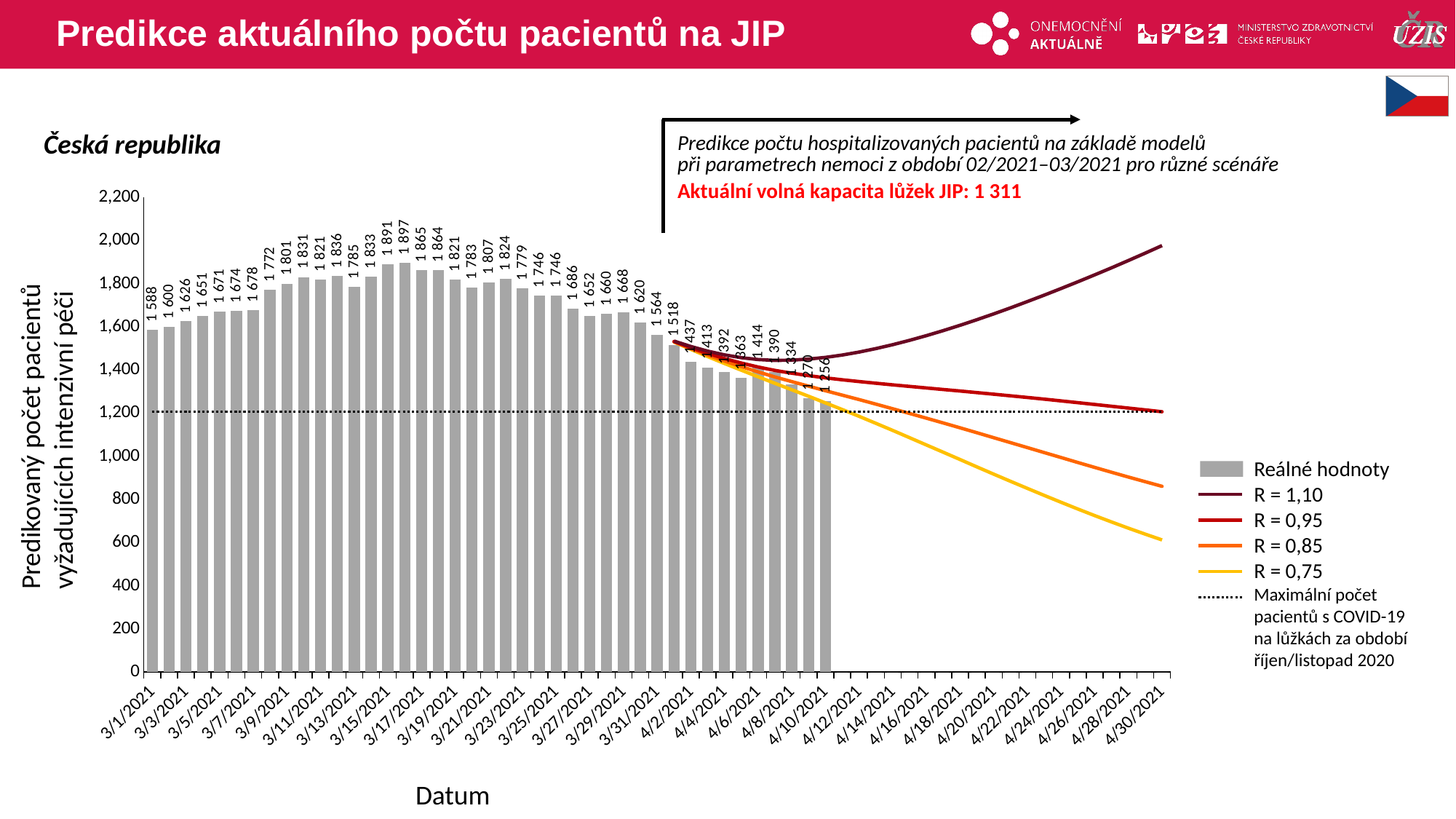
Is the value of the R = 0,75 line at 4/30/2021 greater or less than 800? less How many entries does the legend list? 6 What is the lowest value among the bars (Reálné hodnoty)? 1 256 Is the value of the R = 1,10 line at 4/30/2021 greater or less than 1,800? greater Which is larger, the bar for 3/1/2021 or the bar for 4/10/2021? 3/1/2021 What is the highest value among the bars (Reálné hodnoty)? 1 897 What is the value of the bar for 4/10/2021, the last bar? 1 256 What is the value of the bar for 3/1/2021? 1 588 How many bars (Reálné hodnoty) are plotted on the chart? 41 What is the value of the bar for 3/31/2021? 1 564 Does the R = 1,10 line rise or fall from 4/12/2021 to 4/30/2021? rises What is the difference between the highest bar value (1 897) and the bar for 3/1/2021 (1 588)? 309